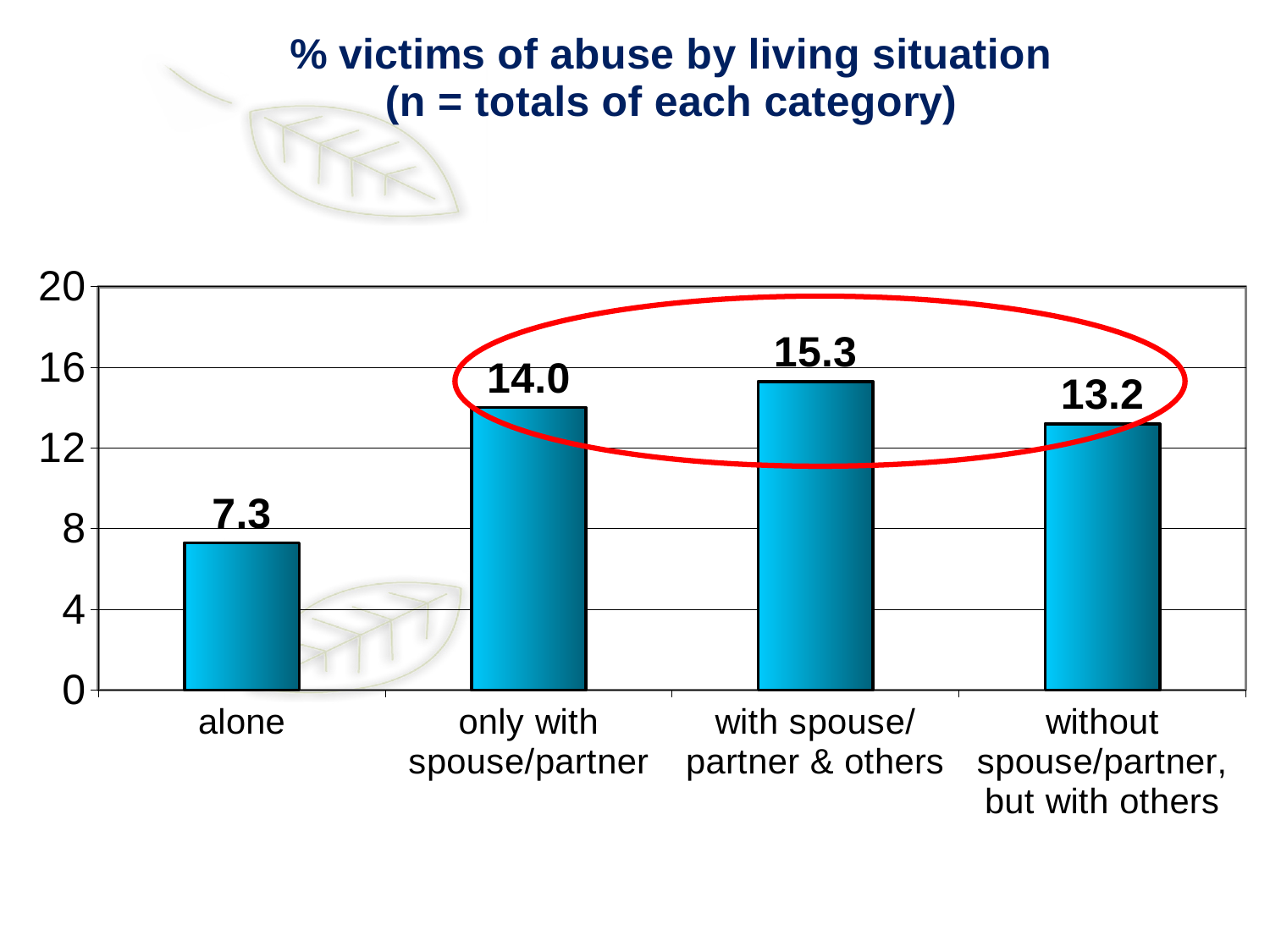
What is the value for 'only with spouse/partner'? 14.0 Which is larger, the value for 'only with spouse/partner' or the value for 'without spouse/partner, but with others'? only with spouse/partner What is the difference between the values for 'only with spouse/partner' and 'without spouse/partner, but with others'? 0.8 Which bars are enclosed by the red oval on the chart? only with spouse/partner, with spouse/partner & others, and without spouse/partner, but with others How many living situation categories are shown in the chart? 4 What kind of chart is shown on the slide? bar chart Which living situation has the highest percentage of victims of abuse? with spouse/partner & others What is the value for 'with spouse/partner & others'? 15.3 What is the value for 'without spouse/partner, but with others'? 13.2 What is the difference between the values for 'with spouse/partner & others' and 'alone'? 8.0 Which living situation has the lowest percentage of victims of abuse? alone What is the value for the 'alone' category? 7.3